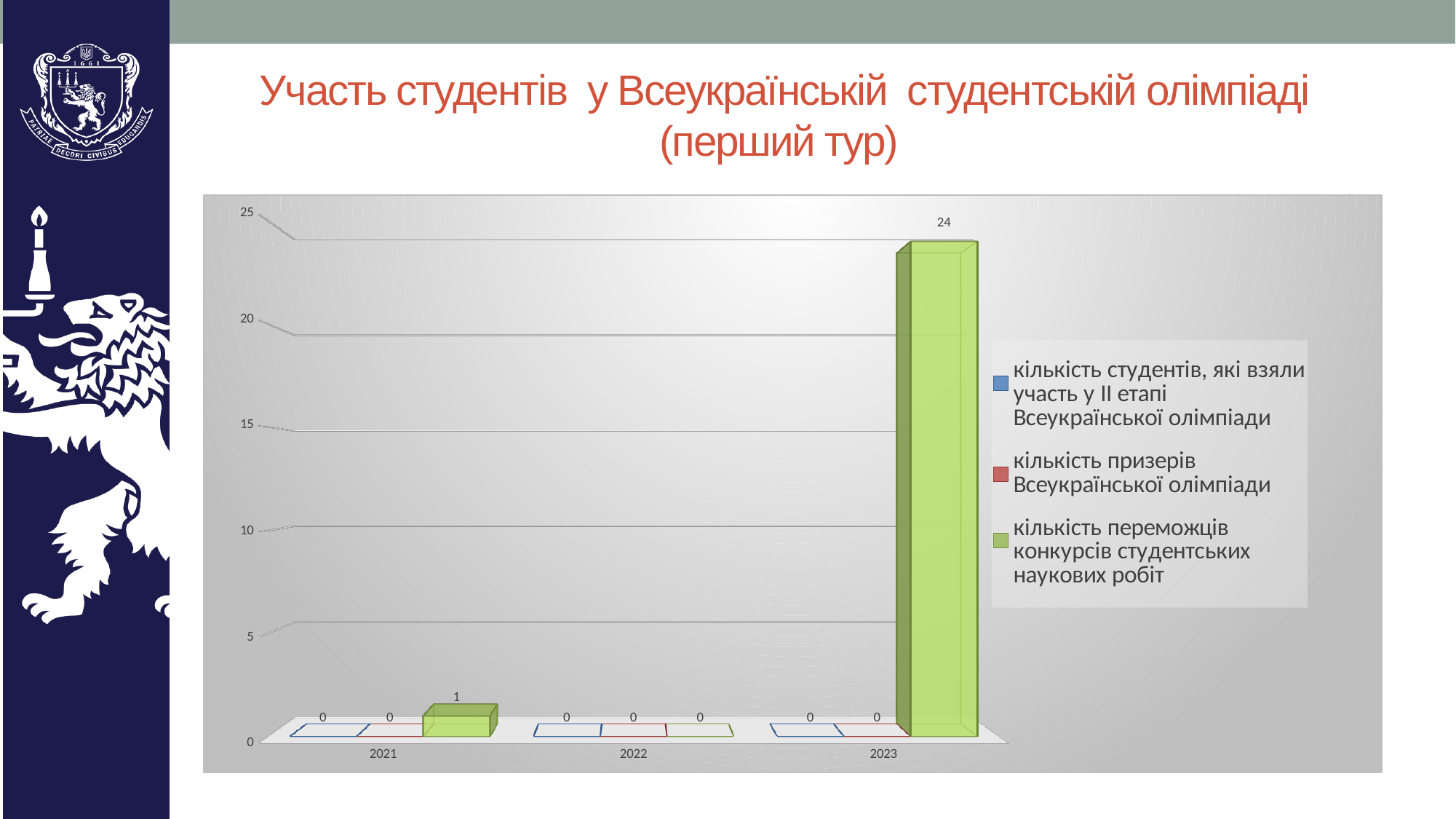
Is the 2023 value for 'кількість переможців конкурсів студентських наукових робіт' greater or less than 20? greater How many years are shown on the x axis? 3 What is the value for 'кількість студентів, які взяли участь у ІІ етапі Всеукраїнської олімпіади' in 2023? 0 What is the value for 'кількість призерів Всеукраїнської олімпіади' in 2022? 0 What is the value for 'кількість переможців конкурсів студентських наукових робіт' in 2021? 1 How many series does the legend list? 3 Which is larger: the 2021 or the 2022 value for 'кількість переможців конкурсів студентських наукових робіт'? 2021 What kind of chart is shown on the slide? bar chart What colour represents 'кількість призерів Всеукраїнської олімпіади' in the legend? red What is the value for 'кількість переможців конкурсів студентських наукових робіт' in 2023? 24 In which year is the value for 'кількість переможців конкурсів студентських наукових робіт' highest? 2023 What is the difference between the 2023 and 2021 values for 'кількість переможців конкурсів студентських наукових робіт'? 23